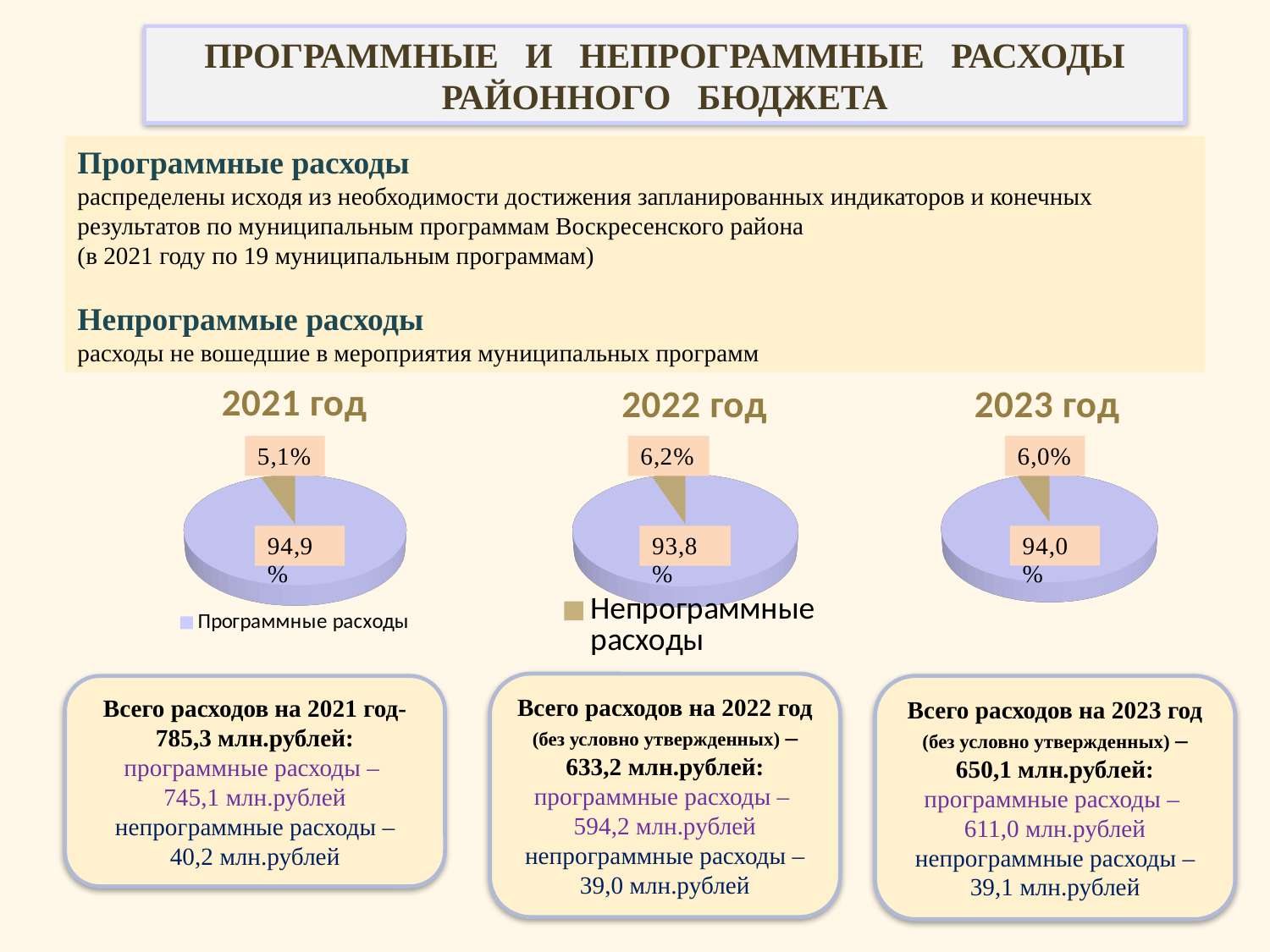
How many pie charts are shown on the slide? 3 How many slices does the 2022 год pie chart have? 2 In the 2022 год pie chart, what share is labelled for the small slice (непрограммные расходы)? 6,2% In the 2023 год pie chart, what share is labelled for the large slice (программные расходы)? 94,0% In the 2021 год pie chart, what share is labelled for the large slice (программные расходы)? 94,9% In the 2023 год pie chart, what share is labelled for the small slice (непрограммные расходы)? 6,0% What kind of chart is used for each of the three years on the slide? Pie chart Which year's pie chart shows the largest share for непрограммные расходы: 2021, 2022 or 2023? 2022 год Which year's pie chart shows the smallest share for непрограммные расходы: 2021, 2022 or 2023? 2021 год What is the difference between the непрограммные расходы share in the 2022 год chart and in the 2021 год chart? 1,1% In the 2022 год pie chart, what share is labelled for the large slice (программные расходы)? 93,8% In the 2021 год pie chart, what share is labelled for the small slice (непрограммные расходы)? 5,1%